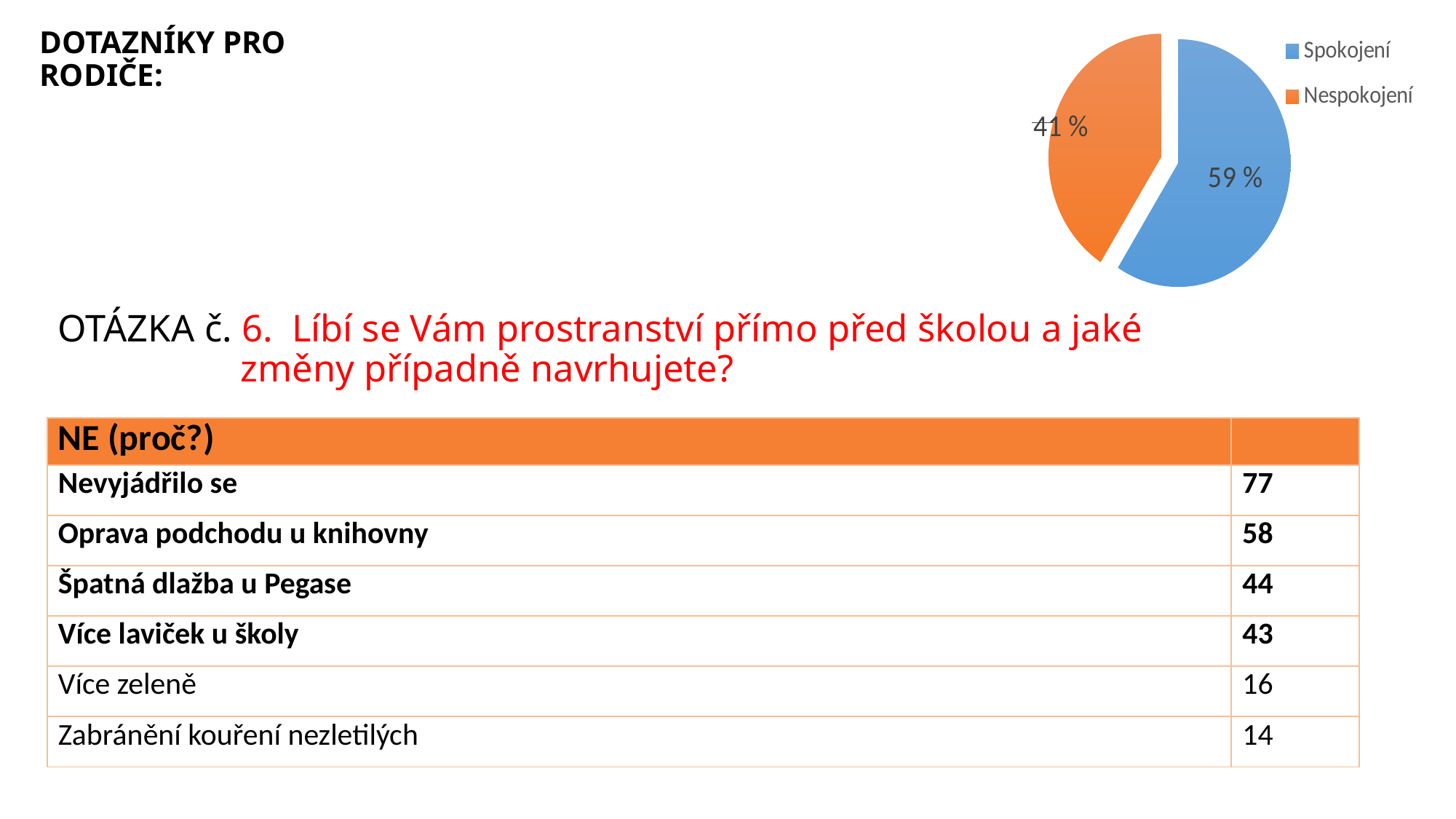
What is the value for Nespokojení in the pie chart? 41 % How many slices does the pie chart have? 2 Which slice of the pie chart is the largest? Spokojení What kind of chart is shown on the slide? pie chart Which is larger in the pie chart, Spokojení or Nespokojení? Spokojení What is the difference between the Spokojení and Nespokojení shares in the pie chart? 18 % What colour is the Spokojení slice in the pie chart? blue How many entries does the pie chart legend list? 2 What is the value for Spokojení in the pie chart? 59 % Which slice of the pie chart is the smallest? Nespokojení What share of the pie does the Nespokojení slice represent? 41 % What colour is the Nespokojení slice in the pie chart? orange